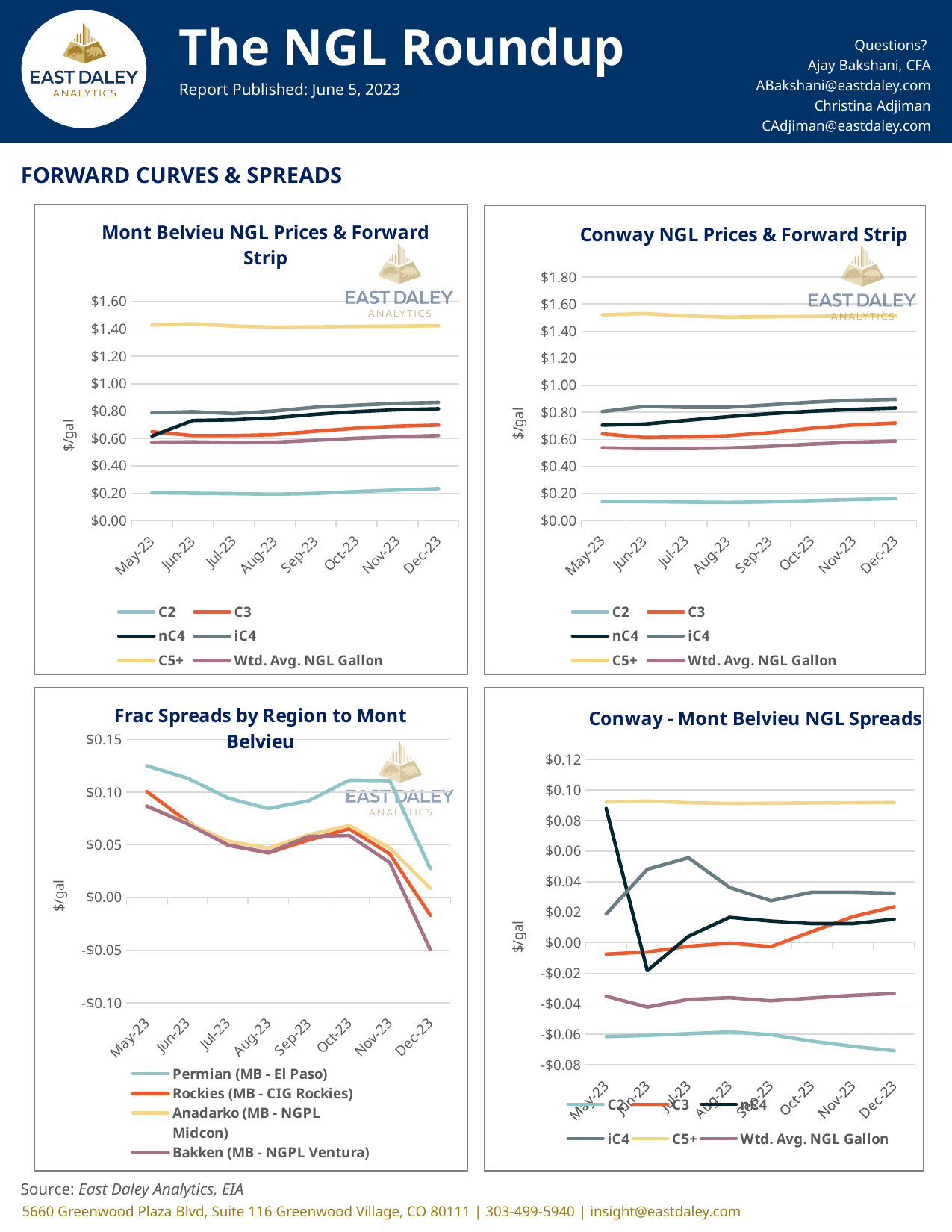
In the 'Mont Belvieu NGL Prices & Forward Strip' chart, is the value for C2 in Dec-23 greater or less than $0.40? less What kind of chart is the 'Mont Belvieu NGL Prices & Forward Strip' chart? Line chart In the 'Conway NGL Prices & Forward Strip' chart, is the value for C5+ in May-23 greater or less than $1.40? greater In the 'Conway NGL Prices & Forward Strip' chart, which series has the lowest values? C2 In the 'Frac Spreads by Region to Mont Belvieu' chart, which series has the lowest value in Dec-23? Bakken (MB - NGPL Ventura) In the 'Conway - Mont Belvieu NGL Spreads' chart, does the C2 series rise or fall from May-23 to Dec-23? Fall In the 'Frac Spreads by Region to Mont Belvieu' chart, how many series does the legend list? 4 In the 'Conway NGL Prices & Forward Strip' chart, which is larger in Dec-23, iC4 or C3? iC4 How many charts are shown on the slide? 4 In the 'Mont Belvieu NGL Prices & Forward Strip' chart, how many series does the legend list? 6 In the 'Mont Belvieu NGL Prices & Forward Strip' chart, which series has the highest values? C5+ In the 'Mont Belvieu NGL Prices & Forward Strip' chart, how many months are shown on the x axis? 8